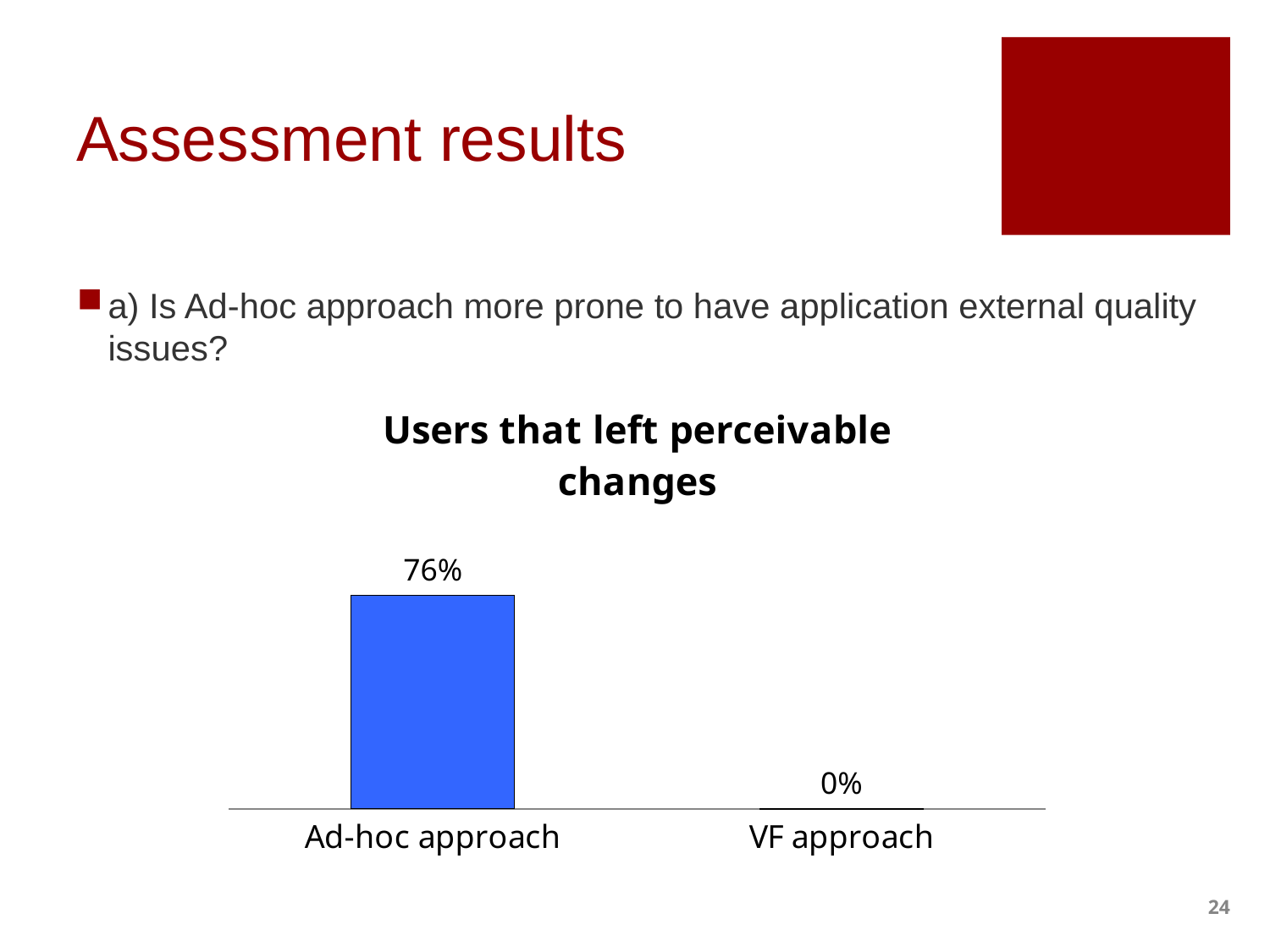
What is the title of the chart? Users that left perceivable changes Which category has the highest value? Ad-hoc approach Which is larger, the value for Ad-hoc approach or the value for VF approach? Ad-hoc approach What is the value for VF approach? 0% What is the difference between the values for Ad-hoc approach and VF approach? 76% How many categories are shown in the chart? 2 What kind of chart is shown on the slide? Bar chart What colour is the bar for Ad-hoc approach? Blue Which category has the lowest value? VF approach What is the value for Ad-hoc approach? 76%